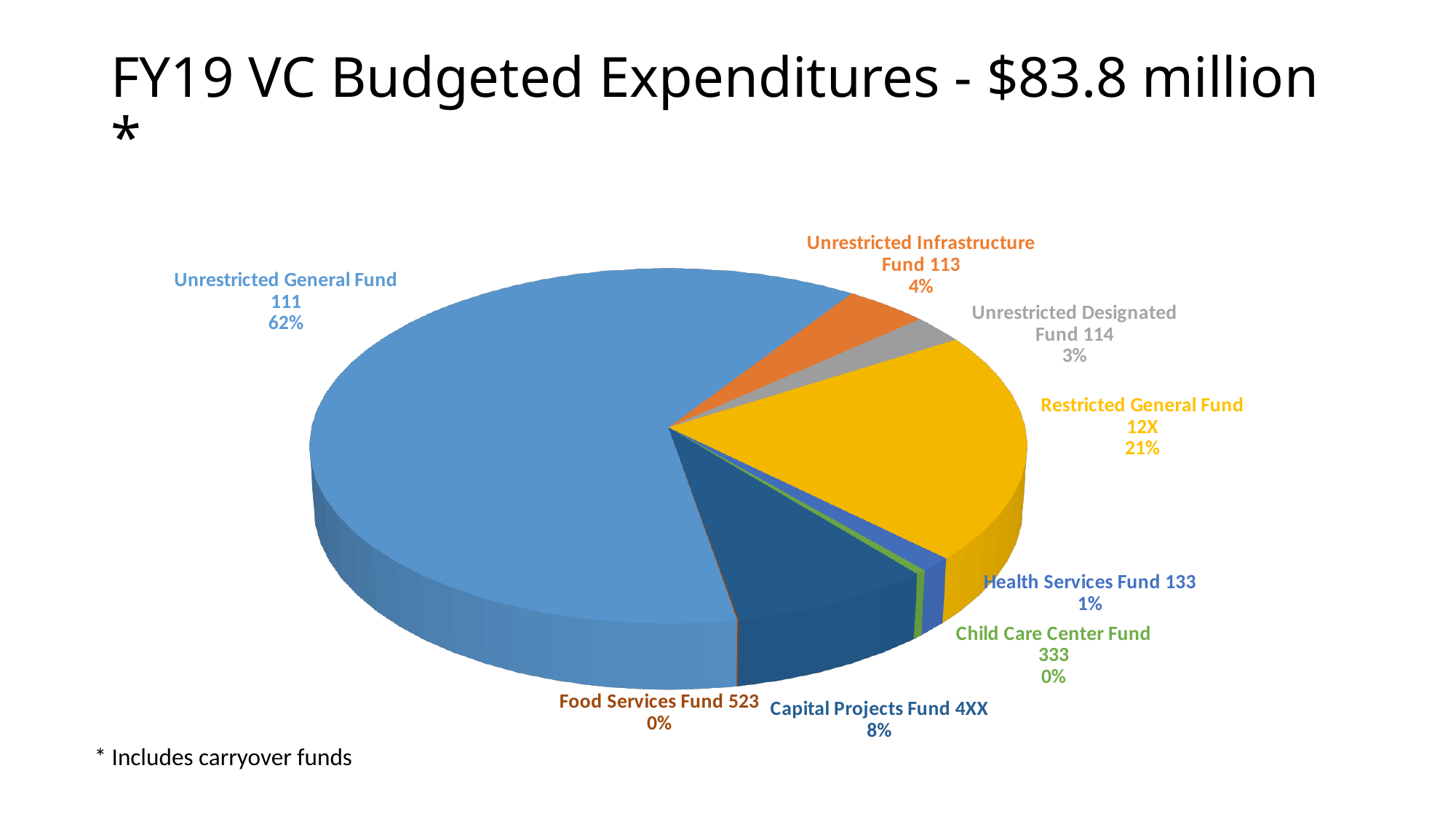
What share of the pie does Unrestricted General Fund 111 represent? 62% What kind of chart is shown on the slide? Pie chart What is the title of the slide? FY19 VC Budgeted Expenditures - $83.8 million * What percentage is shown for Unrestricted Designated Fund 114? 3% What percentage is shown for Unrestricted Infrastructure Fund 113? 4% Which is larger, the share for Restricted General Fund 12X or the share for Capital Projects Fund 4XX? Restricted General Fund 12X What percentage is shown for Health Services Fund 133? 1% What percentage is shown for Capital Projects Fund 4XX? 8% How many slices are labelled on the pie chart? 8 What is the difference in percentage points between Unrestricted General Fund 111 and Restricted General Fund 12X? 41 Which fund has the largest share of the pie? Unrestricted General Fund 111 What percentage is shown for Restricted General Fund 12X? 21%